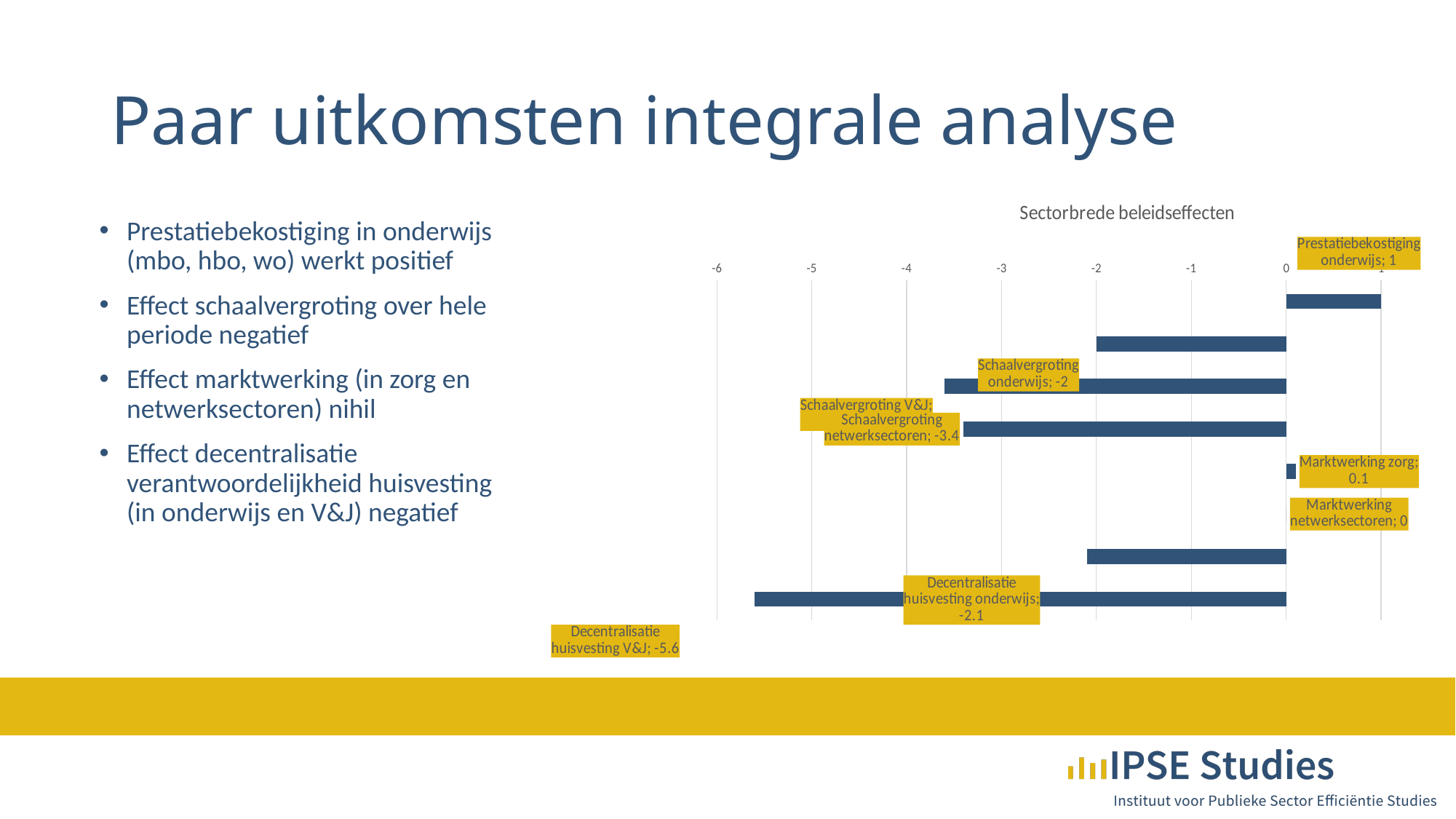
What is the title of the chart? Sectorbrede beleidseffecten What is the value for Prestatiebekostiging onderwijs? 1 What is the value for Decentralisatie huisvesting onderwijs? -2.1 What is the value for Marktwerking zorg? 0.1 Which category has the lowest value? Decentralisatie huisvesting V&J Is the value for Schaalvergroting V&J greater or less than -3? less What is the difference between the values for Schaalvergroting onderwijs and Decentralisatie huisvesting onderwijs? 0.1 What is the value for Schaalvergroting netwerksectoren? -3.4 What kind of chart is shown on the slide? bar chart How many bars are plotted in the chart? 8 What is the value for Decentralisatie huisvesting V&J? -5.6 Which category has the highest value? Prestatiebekostiging onderwijs